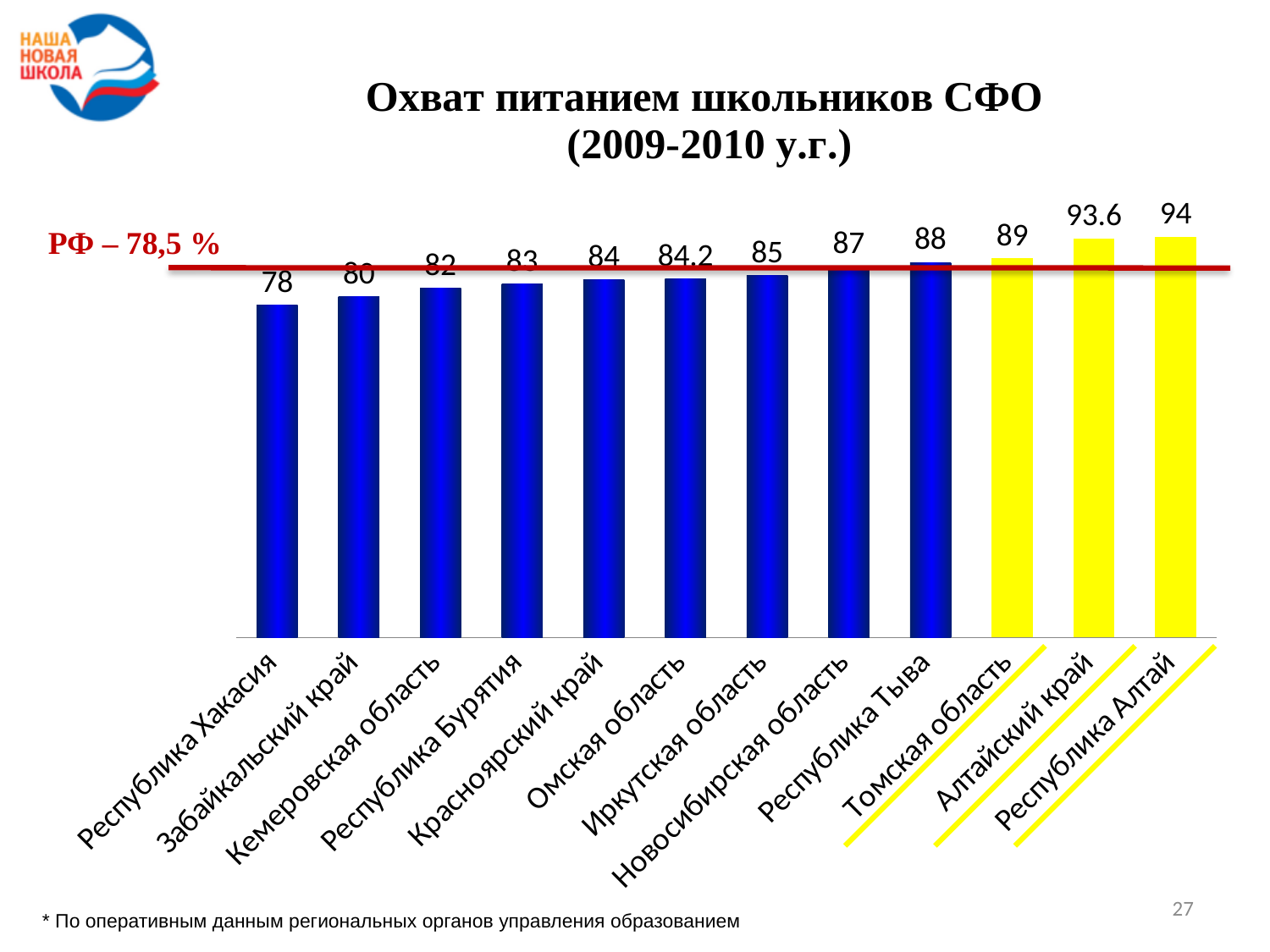
What is the value for Алтайский край? 93.6 What is the value for Республика Хакасия? 78 What is the value for Республика Тыва? 88 Do the values rise or fall from left to right across the regions? Rise What kind of chart is shown on the slide? Bar chart Which region has the lowest value? Республика Хакасия Which is larger, the value for Томская область or the value for Новосибирская область? Томская область What is the difference between the values for Республика Алтай and Республика Хакасия? 16 What is the value for Омская область? 84.2 Which region has the highest value? Республика Алтай How many regions are shown in the chart? 12 What value does the red horizontal line labelled РФ represent? 78,5 %